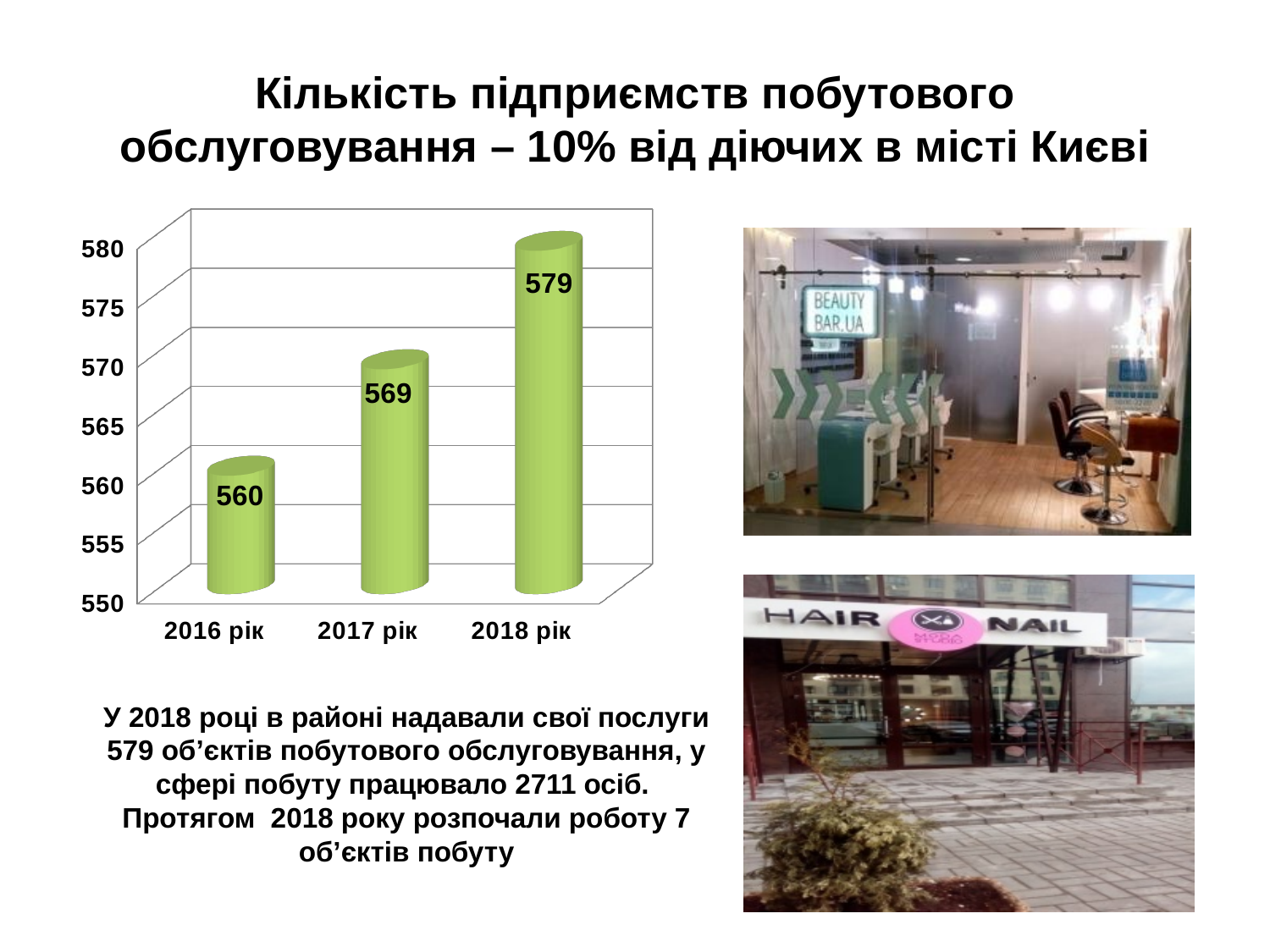
Do the values rise or fall from 2016 рік to 2018 рік? rise Which year has the lowest value? 2016 рік What is the value for 2018 рік? 579 What is the value for 2016 рік? 560 What is the difference between the values for 2018 рік and 2016 рік? 19 What is the value for 2017 рік? 569 What kind of chart is shown on the slide? bar chart Is the value for 2017 рік greater or less than 565? greater What is the difference between the values for 2017 рік and 2016 рік? 9 Which is larger, the value for 2017 рік or the value for 2018 рік? 2018 рік How many categories are shown on the x axis? 3 Which year has the highest value? 2018 рік